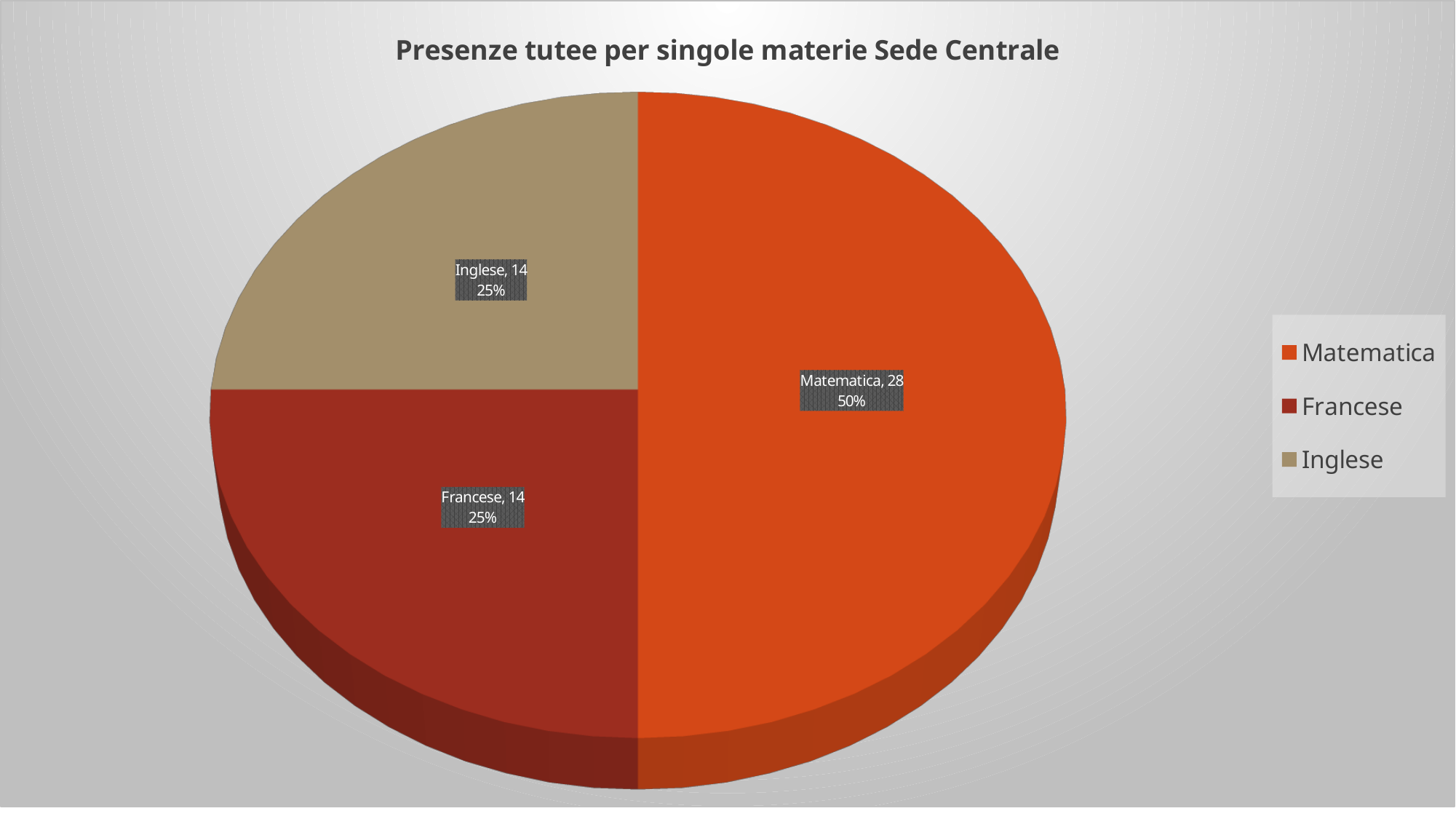
Which is larger, the value for Matematica or the value for Inglese? Matematica What is the title of the chart? Presenze tutee per singole materie Sede Centrale How many categories are shown in the pie chart? 3 What is the value for Matematica? 28 What is the value for Inglese? 14 What share of the pie does Inglese represent? 25% What kind of chart is shown on the slide? Pie chart What share of the pie does Matematica represent? 50% What is the difference between the values for Matematica and Francese? 14 What is the total of all the values shown in the pie chart? 56 Which category has the largest slice? Matematica What is the value for Francese? 14